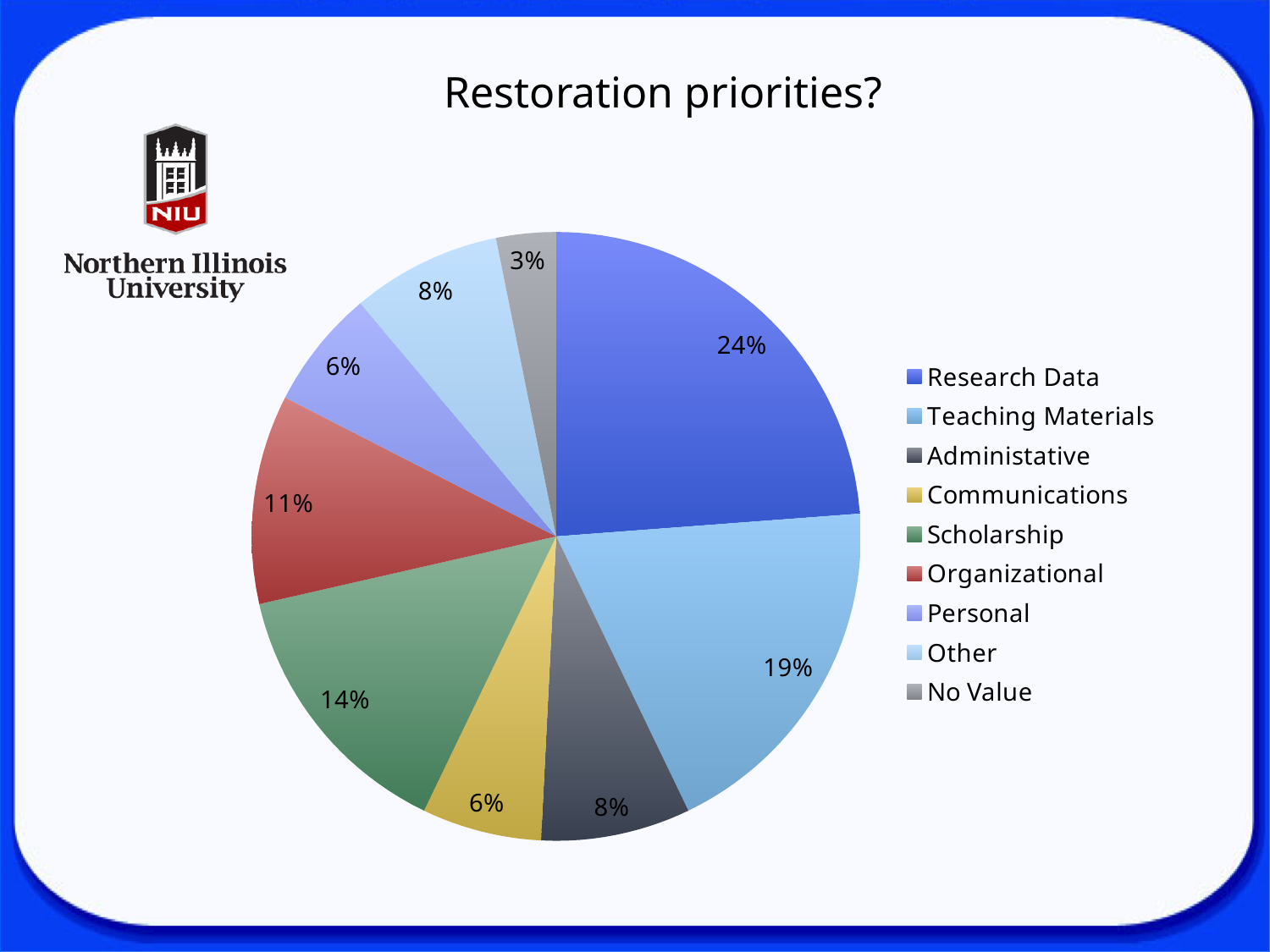
What share of the pie does No Value represent? 3% What share of the pie does Teaching Materials represent? 19% What type of chart is shown on the slide? pie chart What is the title of the chart? Restoration priorities? Which category has the largest slice of the pie? Research Data Which is larger, the Scholarship slice or the Organizational slice? Scholarship What share of the pie does Scholarship represent? 14% What share of the pie does Organizational represent? 11% What share of the pie does Research Data represent? 24% What is the difference in percentage points between Research Data and Teaching Materials? 5 How many categories does the legend list? 9 Which category has the smallest slice of the pie? No Value